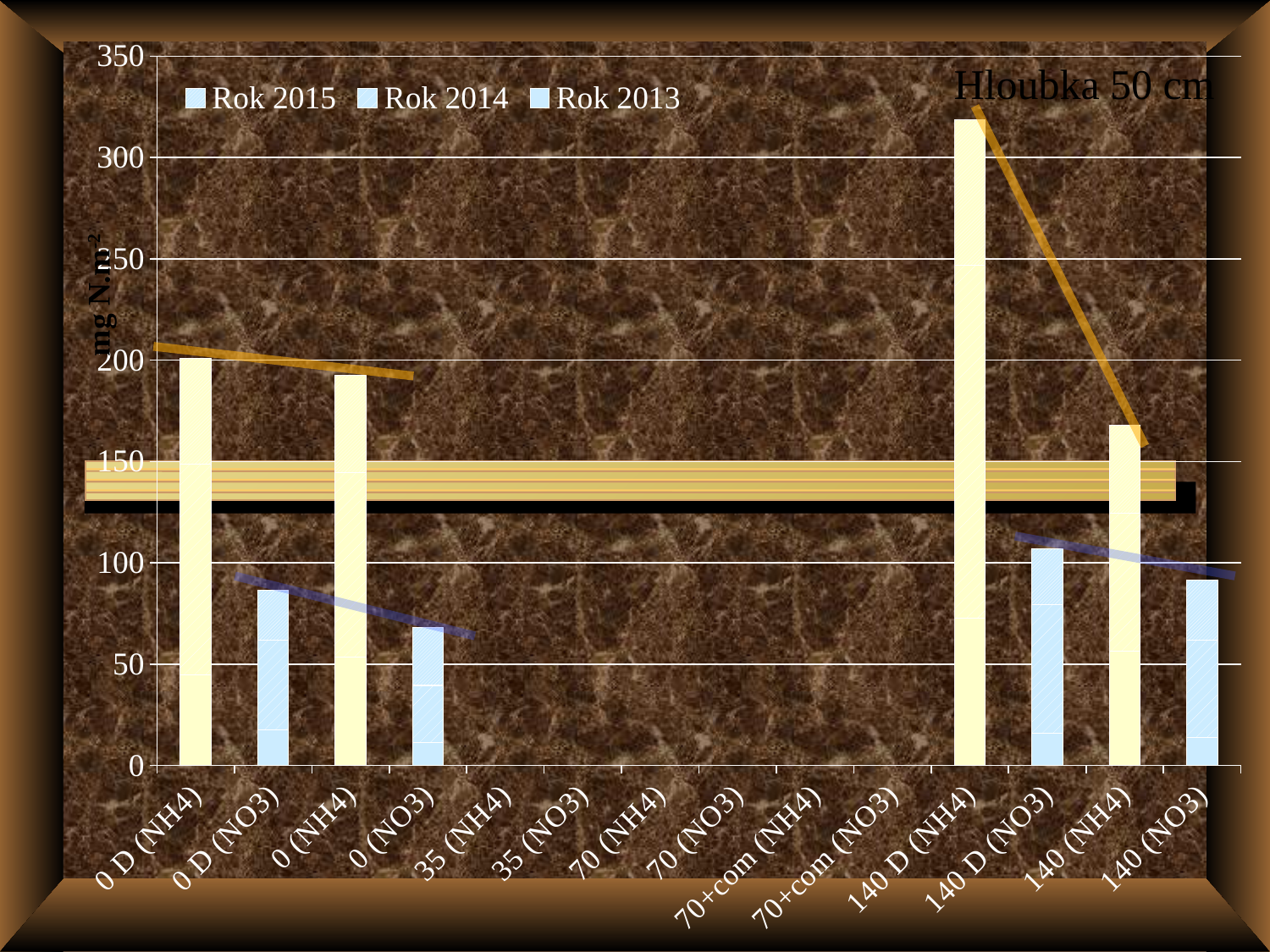
What kind of chart is shown on the slide? bar chart Is the value for 0 (NH4) greater or less than 150? greater Which series are listed in the legend? Rok 2015, Rok 2014, Rok 2013 Is the value for 140 D (NH4) greater or less than 300? greater Which is larger, the bar for 0 D (NO3) or the bar for 0 (NO3)? 0 D (NO3) Which is larger, the bar for 140 D (NH4) or the bar for 0 D (NH4)? 140 D (NH4) Which category has the tallest bar? 140 D (NH4) What is the title of the chart? Hloubka 50 cm How many categories are shown on the x axis? 14 Is the value for 140 D (NO3) greater or less than 150? less How many series does the legend list? 3